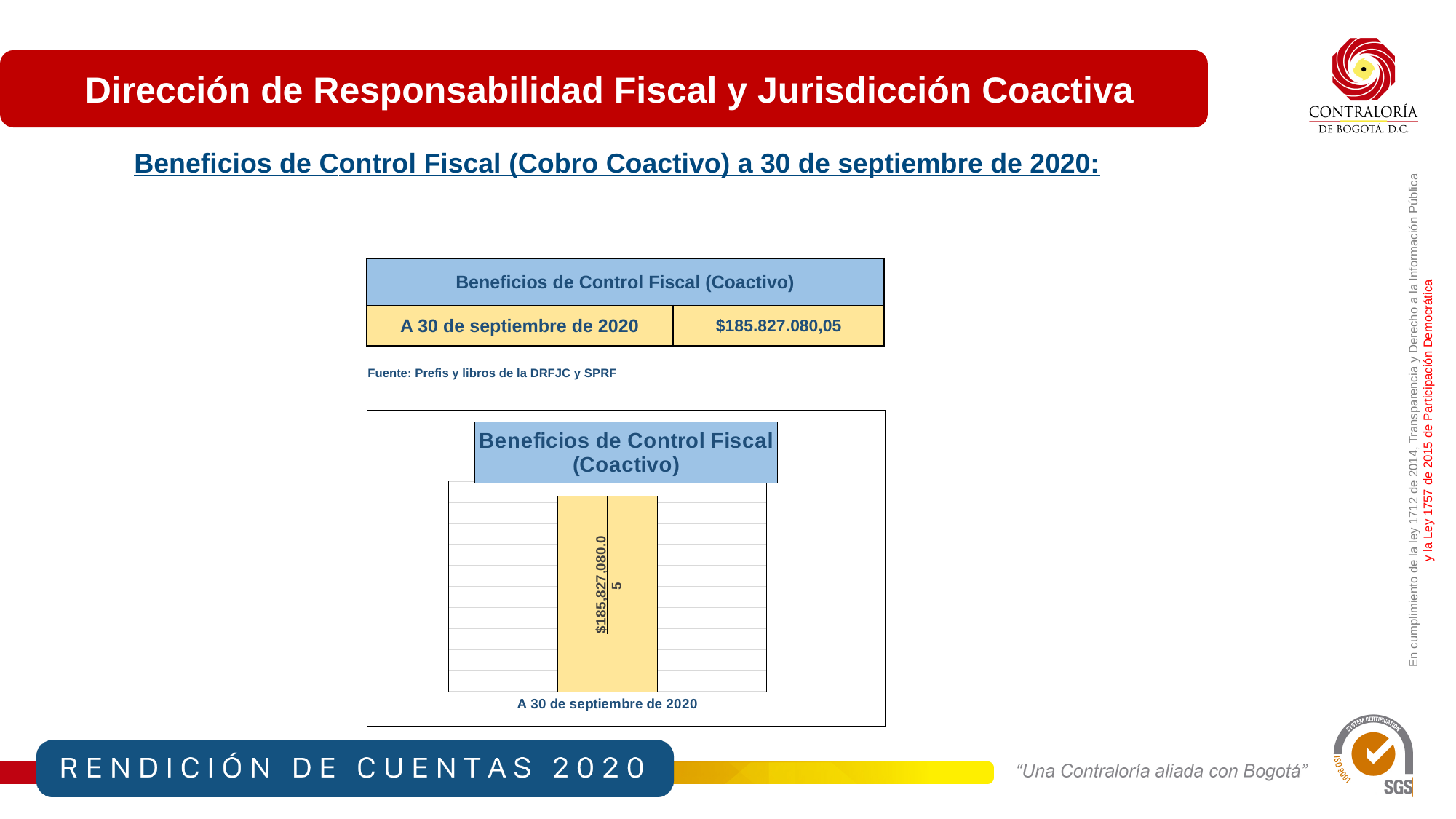
What is the category label shown on the x axis of the chart? A 30 de septiembre de 2020 How many bars are plotted in the chart? 1 What kind of chart is shown on the slide? Bar chart What is the value of the bar for "A 30 de septiembre de 2020" in the chart? $185.827.080,05 What is the title of the chart? Beneficios de Control Fiscal (Coactivo)